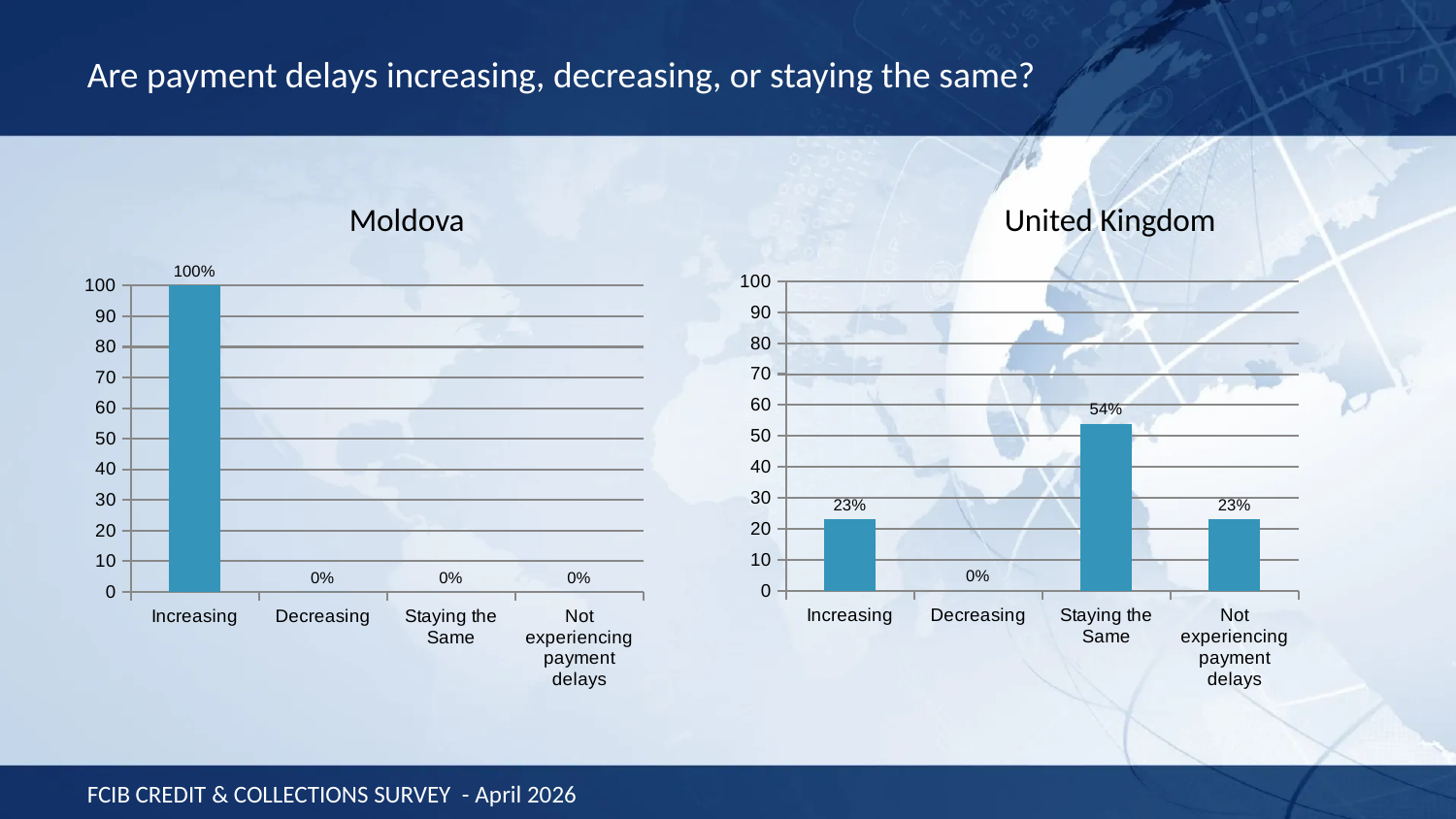
In the United Kingdom chart, which category has the lowest value? Decreasing How many categories are shown in the Moldova chart? 4 In the United Kingdom chart, what is the difference between Staying the Same and Increasing? 31% In the United Kingdom chart, what is the value for Staying the Same? 54% In the Moldova chart, what is the value for Increasing? 100% In the Moldova chart, which category has the highest value? Increasing In the United Kingdom chart, what is the value for Decreasing? 0% In the United Kingdom chart, what is the value for Not experiencing payment delays? 23% What is the title of the chart on the left side of the slide? Moldova What kind of chart is the United Kingdom chart? Bar chart In the United Kingdom chart, which is larger: Increasing or Staying the Same? Staying the Same In the United Kingdom chart, which category has the highest value? Staying the Same